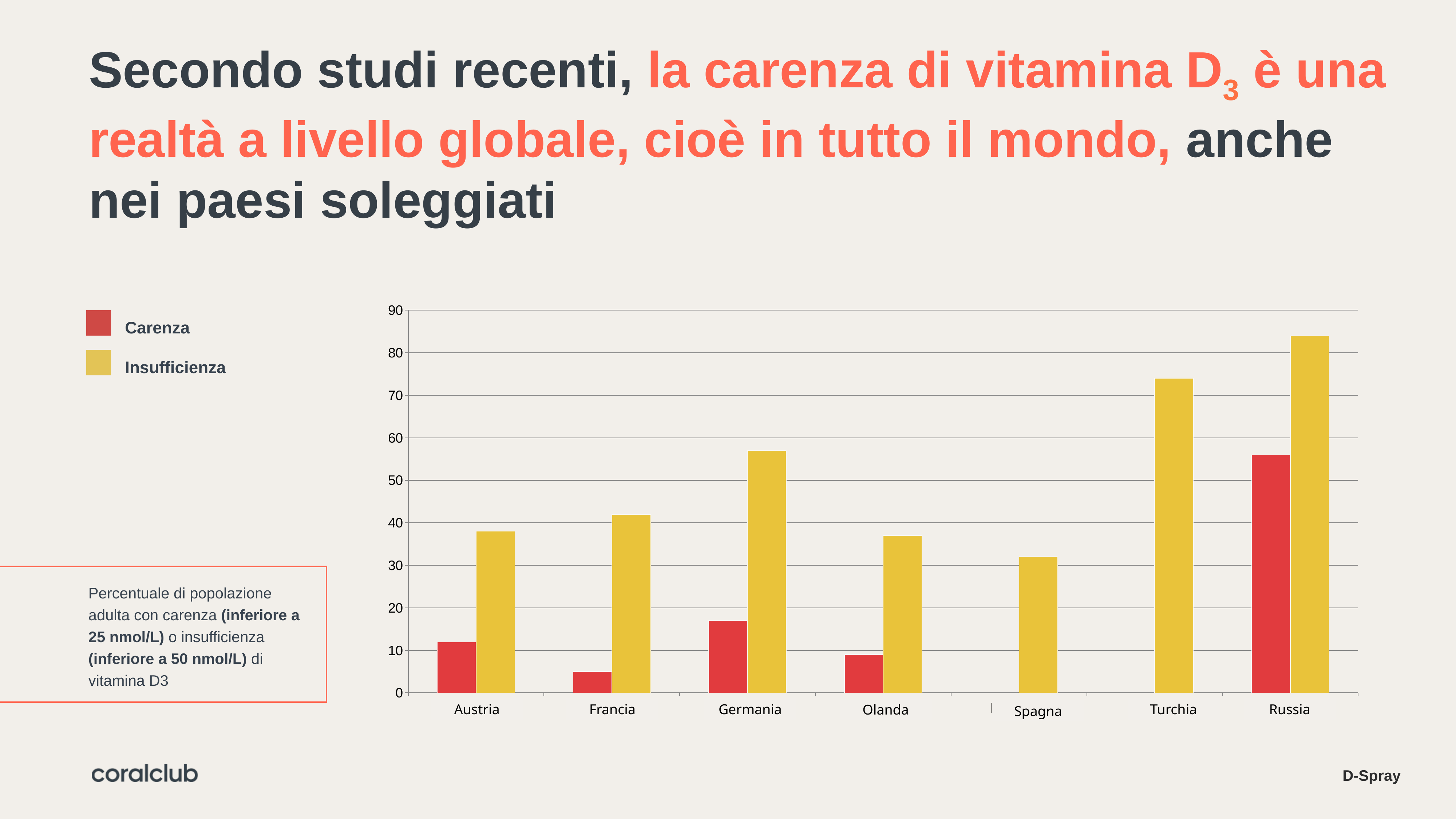
How many series does the chart's legend list? 2 Is the Insufficienza value for Russia greater or less than 80? greater Which colour represents the Carenza series in the chart? red How many countries are shown on the x axis of the chart? 7 Is the Insufficienza value for Germania greater or less than 50? greater Is the Carenza value for Francia greater or less than 10? less Which is larger, the Insufficienza value for Germania or for Francia? Germania Which country has the lowest Insufficienza value? Spagna Which country has the highest Insufficienza value? Russia What kind of chart is shown on the slide? bar chart Which country has the highest Carenza value? Russia